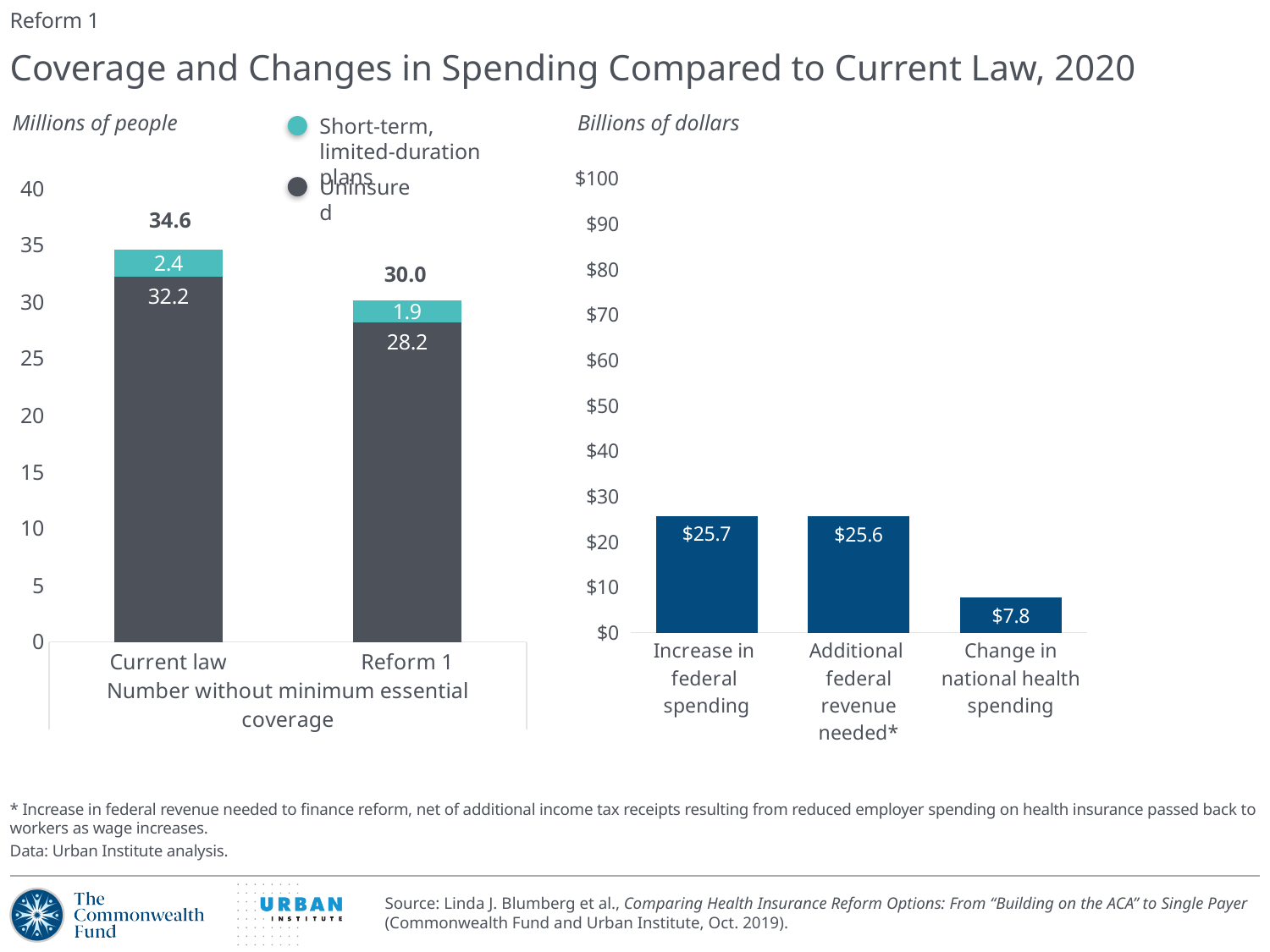
In the right chart (Billions of dollars), what is the value for Change in national health spending? $7.8 In the right chart (Billions of dollars), which category has the lowest value? Change in national health spending In the left chart (Millions of people), what is the difference between the Uninsured values for Current law and Reform 1? 4.0 In the right chart (Billions of dollars), how many categories are shown? 3 In the left chart (Millions of people), what is the Uninsured value for Reform 1? 28.2 In the left chart (Millions of people), how many series does the legend list? 2 In the left chart (Millions of people), what is the total number without minimum essential coverage under Current law? 34.6 In the left chart (Millions of people), what is the total for Reform 1? 30.0 In the right chart (Billions of dollars), what is the value for Increase in federal spending? $25.7 In the left chart (Millions of people), which category has the higher total, Current law or Reform 1? Current law What kind of chart is the right chart (Billions of dollars)? Bar chart In the left chart (Millions of people), what is the Short-term, limited-duration plans value for Current law? 2.4